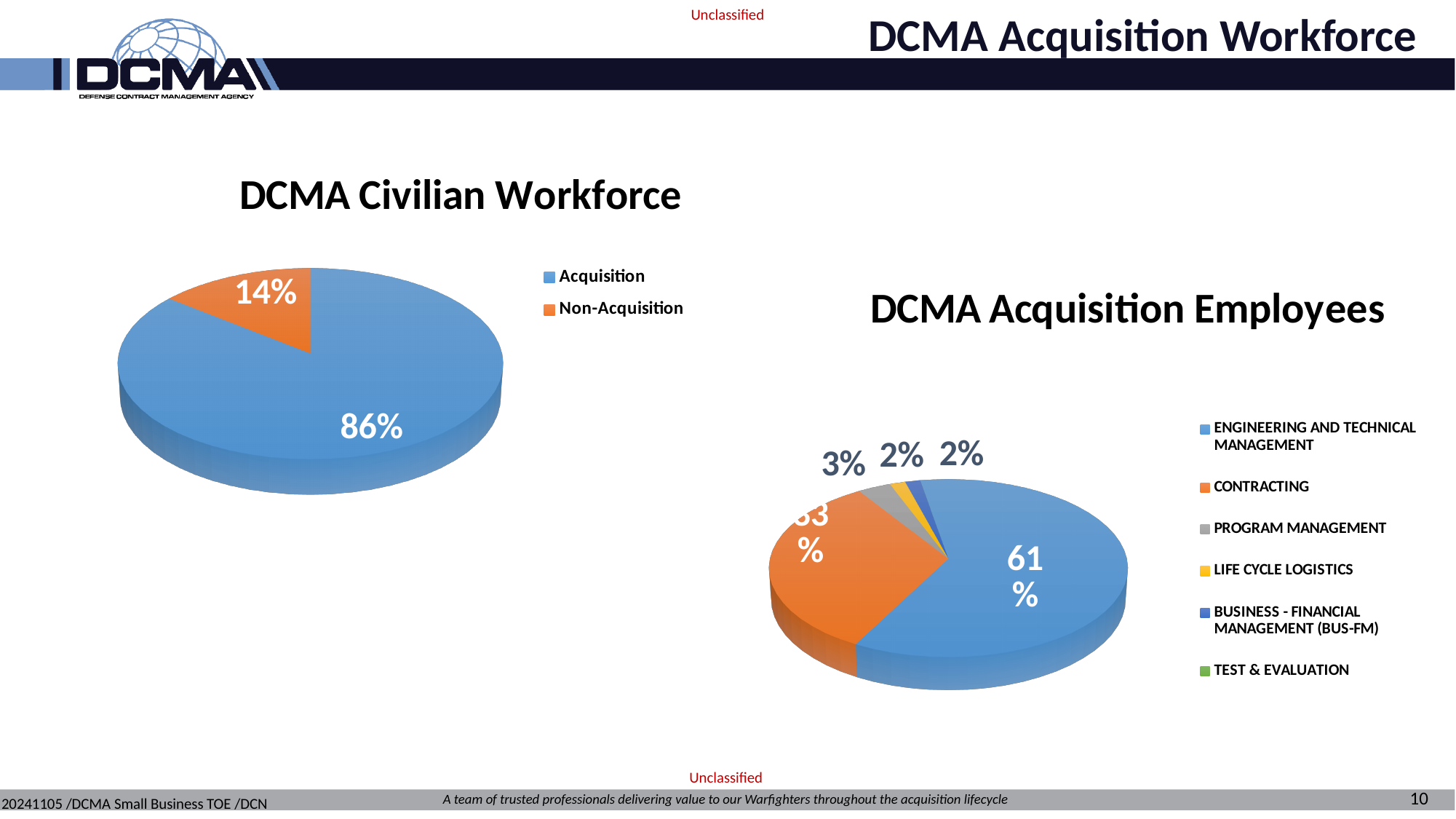
On the DCMA Acquisition Employees chart, which category has the largest slice? Engineering and Technical Management On the DCMA Acquisition Employees chart, what share is Life Cycle Logistics? 2% On the DCMA Civilian Workforce chart, what share of the workforce is Non-Acquisition? 14% How many categories does the legend of the DCMA Acquisition Employees chart list? 6 On the DCMA Acquisition Employees chart, which is larger, Contracting or Program Management? Contracting On the DCMA Civilian Workforce chart, what is the difference in percentage points between Acquisition and Non-Acquisition? 72 On the DCMA Acquisition Employees chart, what share is Program Management? 3% On the DCMA Civilian Workforce chart, which category is the larger slice? Acquisition How many series does the legend of the DCMA Civilian Workforce chart list? 2 On the DCMA Acquisition Employees chart, what share is Engineering and Technical Management? 61% What kind of chart is the DCMA Civilian Workforce chart? Pie chart On the DCMA Civilian Workforce chart, what share of the workforce is Acquisition? 86%